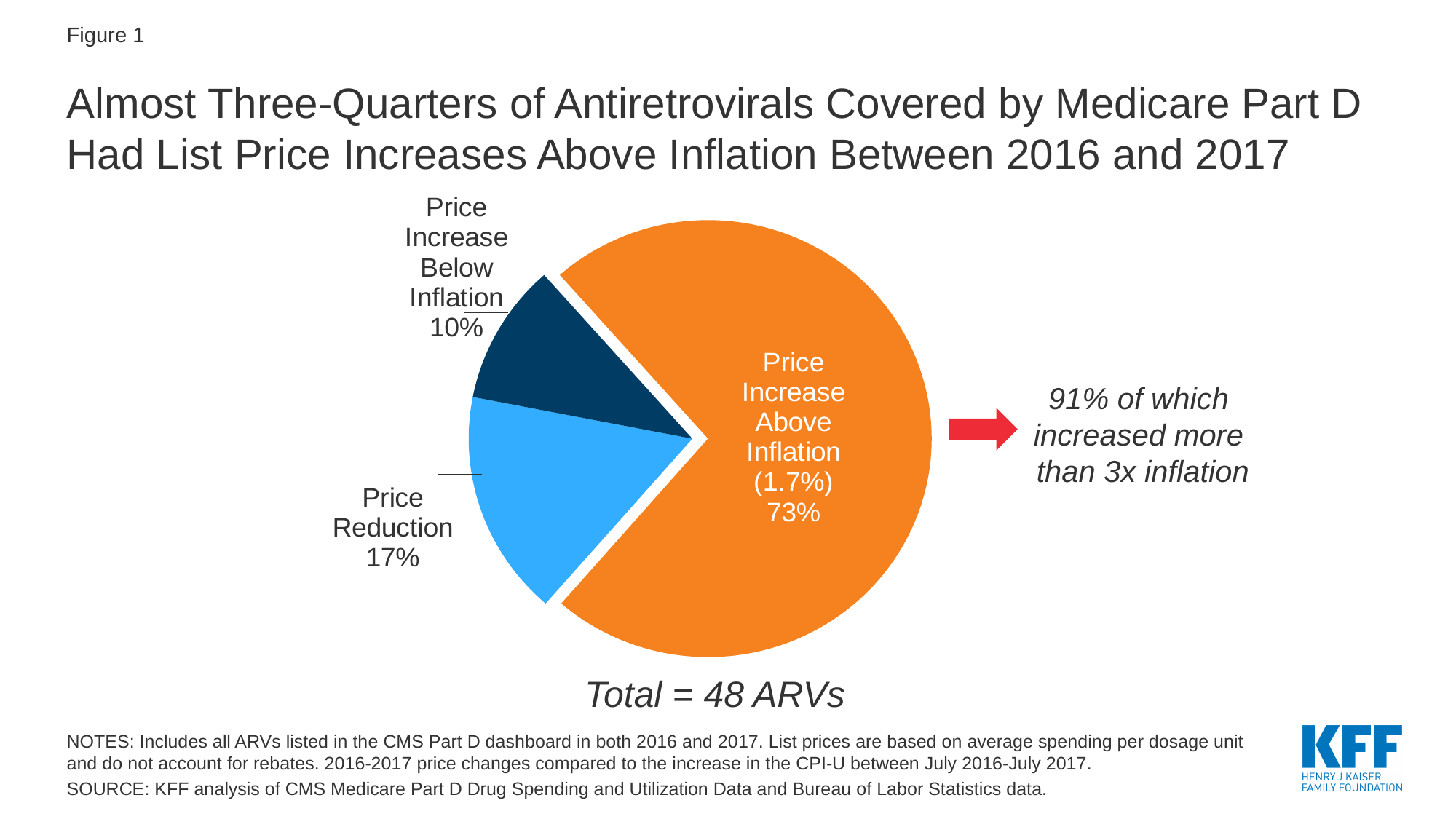
Which category has the smallest share of the pie? Price Increase Below Inflation What share of ARVs had a price reduction? 17% What is the total number of ARVs represented in the pie chart? 48 ARVs How many categories are shown in the pie chart? 3 What kind of chart is shown on the slide? Pie chart What percentage of the ARVs with price increases above inflation increased more than 3x inflation? 91% What is the difference in percentage points between the Price Reduction share and the Price Increase Below Inflation share? 7 percentage points What share of ARVs had a price increase below inflation? 10% Which is larger, the share for Price Reduction or the share for Price Increase Below Inflation? Price Reduction What colour is the Price Increase Above Inflation slice? Orange Which category has the largest share of the pie? Price Increase Above Inflation What share of ARVs had a price increase above inflation? 73%